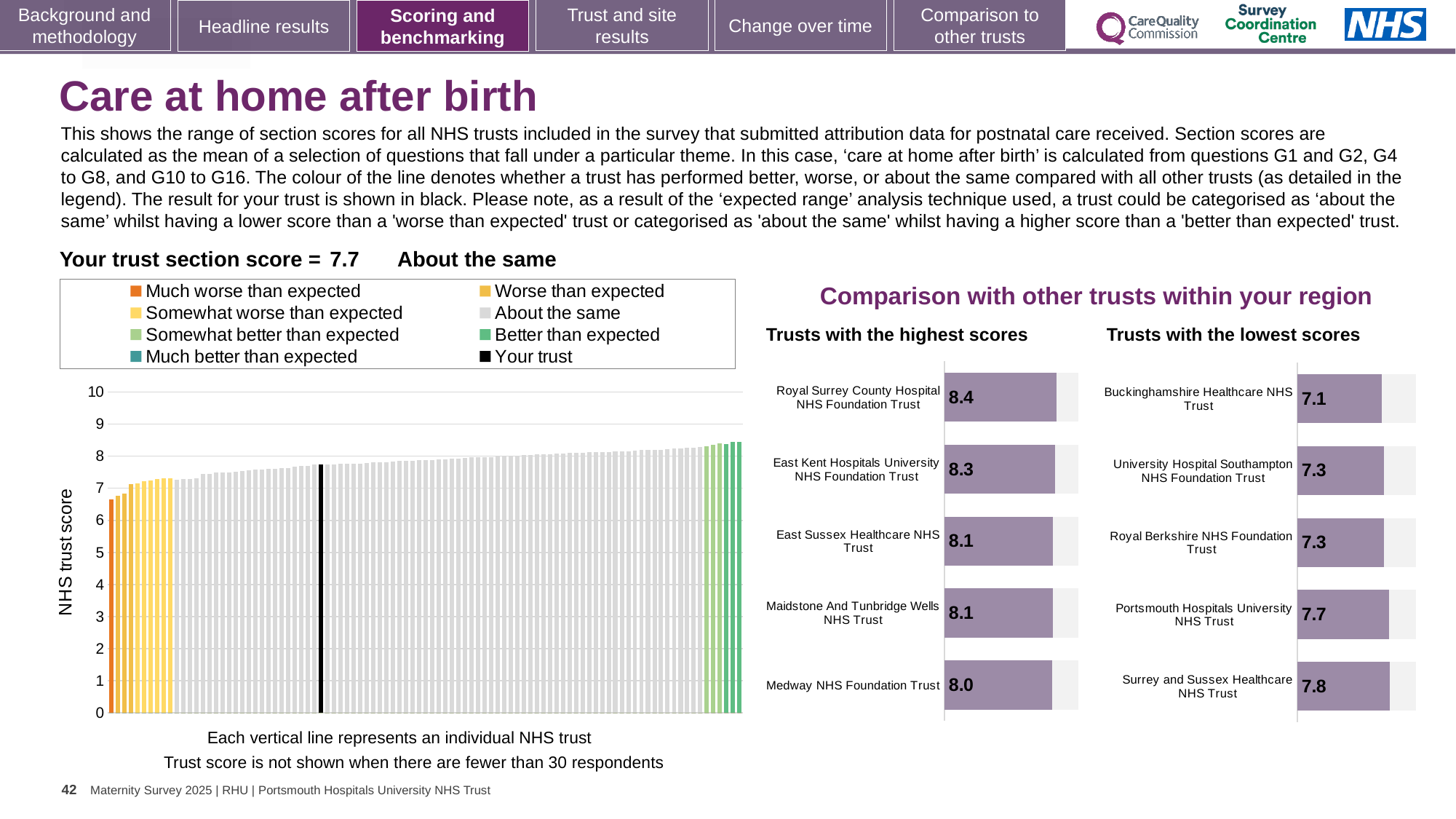
In the 'Trusts with the lowest scores' chart, which trust has the lowest score? Buckinghamshire Healthcare NHS Trust How many entries does the legend above the main 'NHS trust score' chart list? 8 In the 'Trusts with the highest scores' chart, what is the score for Medway NHS Foundation Trust? 8.0 In the main 'NHS trust score' chart, what is the section score for your trust (the black bar)? 7.7 In the 'Trusts with the highest scores' chart, what is the difference between the scores of Royal Surrey County Hospital NHS Foundation Trust and Medway NHS Foundation Trust? 0.4 In the 'Trusts with the highest scores' chart, what is the score for Royal Surrey County Hospital NHS Foundation Trust? 8.4 In the 'Trusts with the lowest scores' chart, how much higher is the score of Surrey and Sussex Healthcare NHS Trust than that of Buckinghamshire Healthcare NHS Trust? 0.7 In the 'Trusts with the highest scores' chart, which trust has the highest score? Royal Surrey County Hospital NHS Foundation Trust In the 'Trusts with the highest scores' chart, which has the larger score: East Kent Hospitals University NHS Foundation Trust or East Sussex Healthcare NHS Trust? East Kent Hospitals University NHS Foundation Trust In the main 'NHS trust score' chart, do the bar values rise or fall from left to right? rise In the 'Trusts with the lowest scores' chart, what is the score for Buckinghamshire Healthcare NHS Trust? 7.1 How many trusts are shown in the 'Trusts with the lowest scores' chart? 5